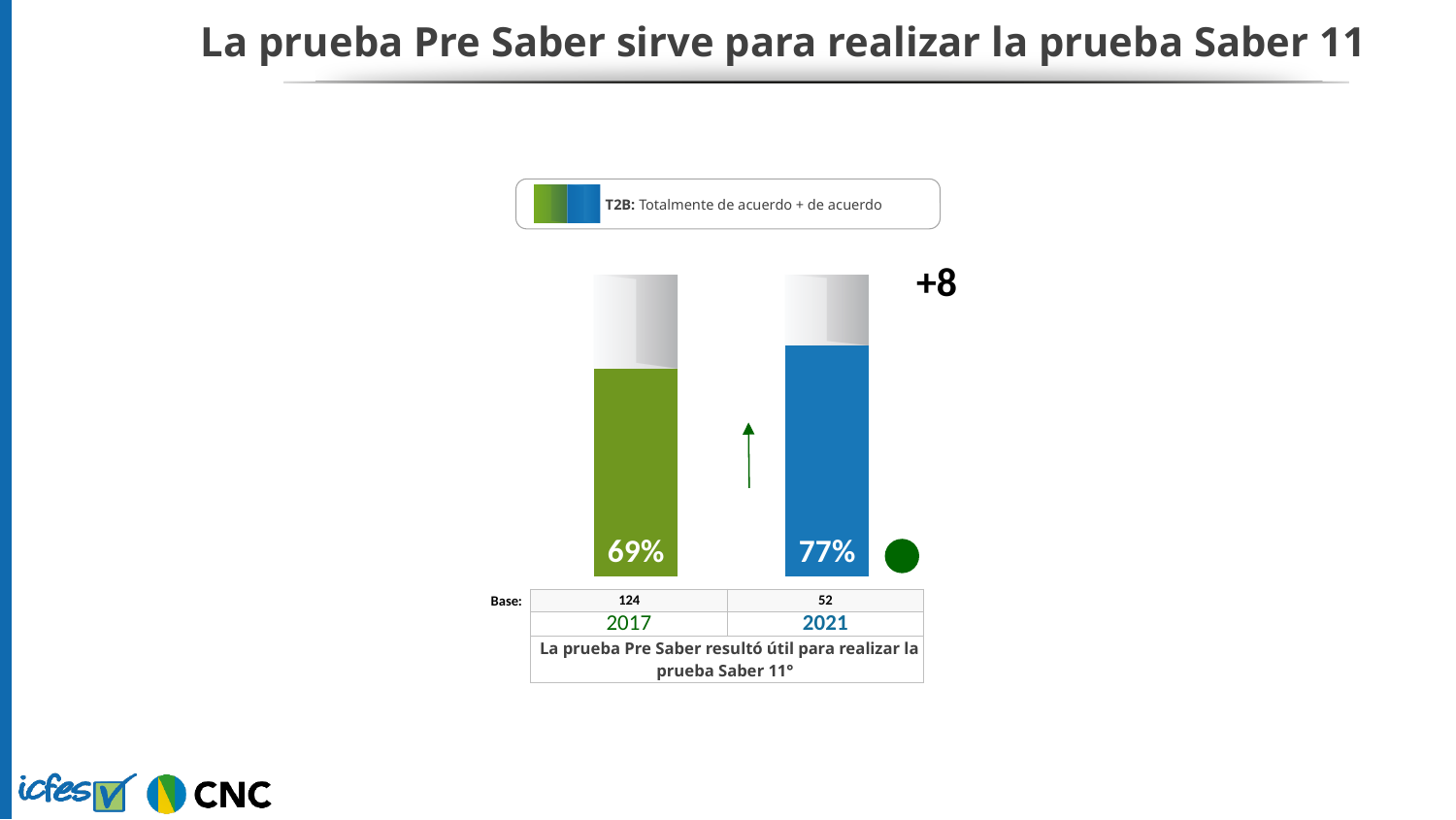
What does T2B stand for according to the legend box? Totalmente de acuerdo + de acuerdo What is the base (sample size) for 2021? 52 How many bars are shown in the chart? 2 Do the values rise or fall from 2017 to 2021? Rise What kind of chart is shown on the slide? Bar chart What is the value for 2017? 69% What is the base (sample size) for 2017? 124 What change is printed above the bars? +8 Which year has the higher value, 2017 or 2021? 2021 Which year has the lowest value? 2017 What is the value for 2021? 77% What is the difference between the 2021 and 2017 values? 8